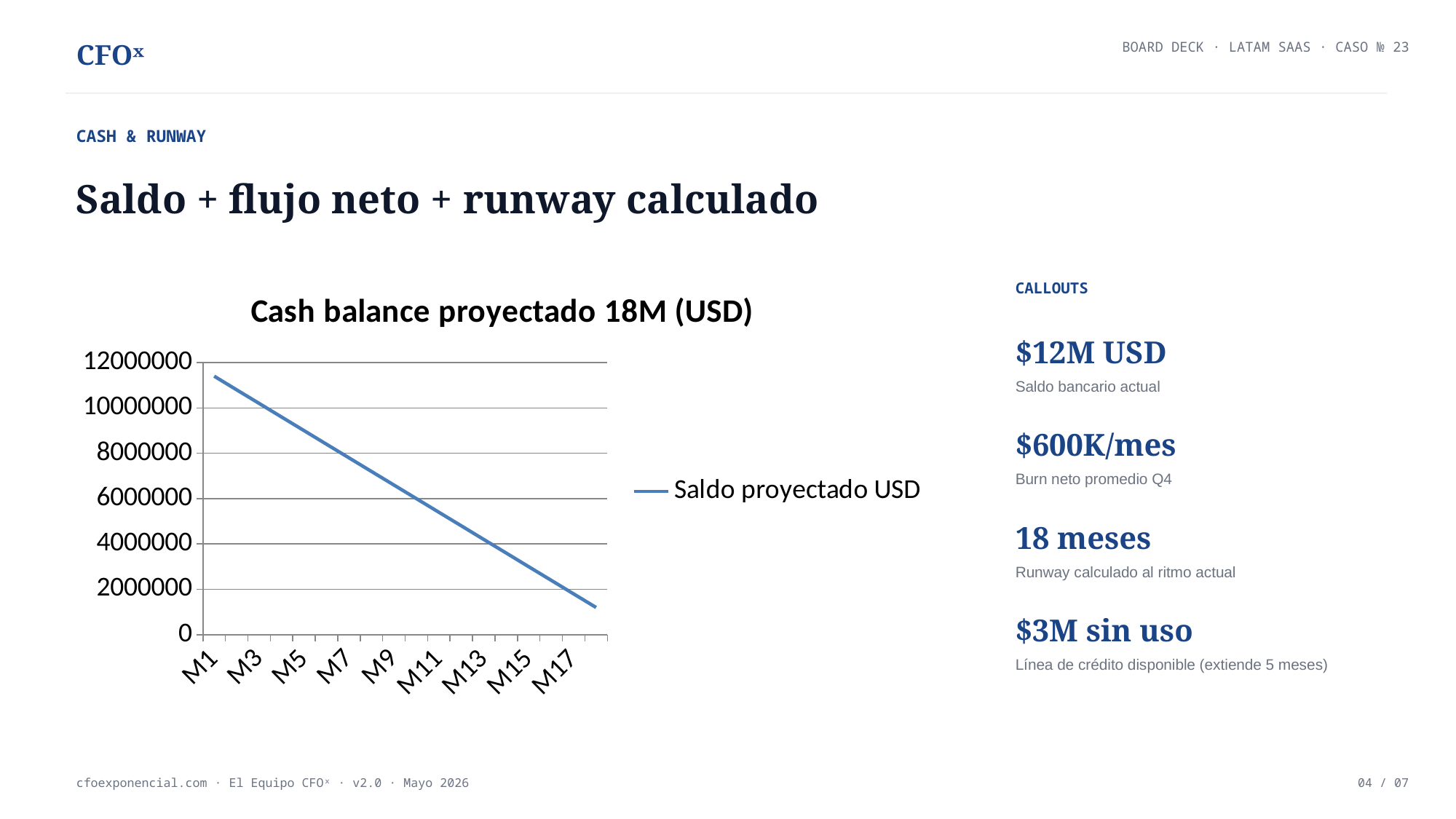
Does the projected cash balance rise or fall from M1 to M17? fall How many series does the chart legend list? 1 What kind of chart is shown on the slide? line chart Is the value for M5 greater or less than 10000000? less Is the value for M1 greater or less than 10000000? greater What is the name of the series shown in the legend? Saldo proyectado USD Which labelled month has the highest projected cash balance? M1 What is the title of the chart? Cash balance proyectado 18M (USD) Is the value for M9 greater or less than 6000000? greater Which labelled month has the lowest projected cash balance? M17 Which is larger, the projected cash balance at M3 or at M13? M3